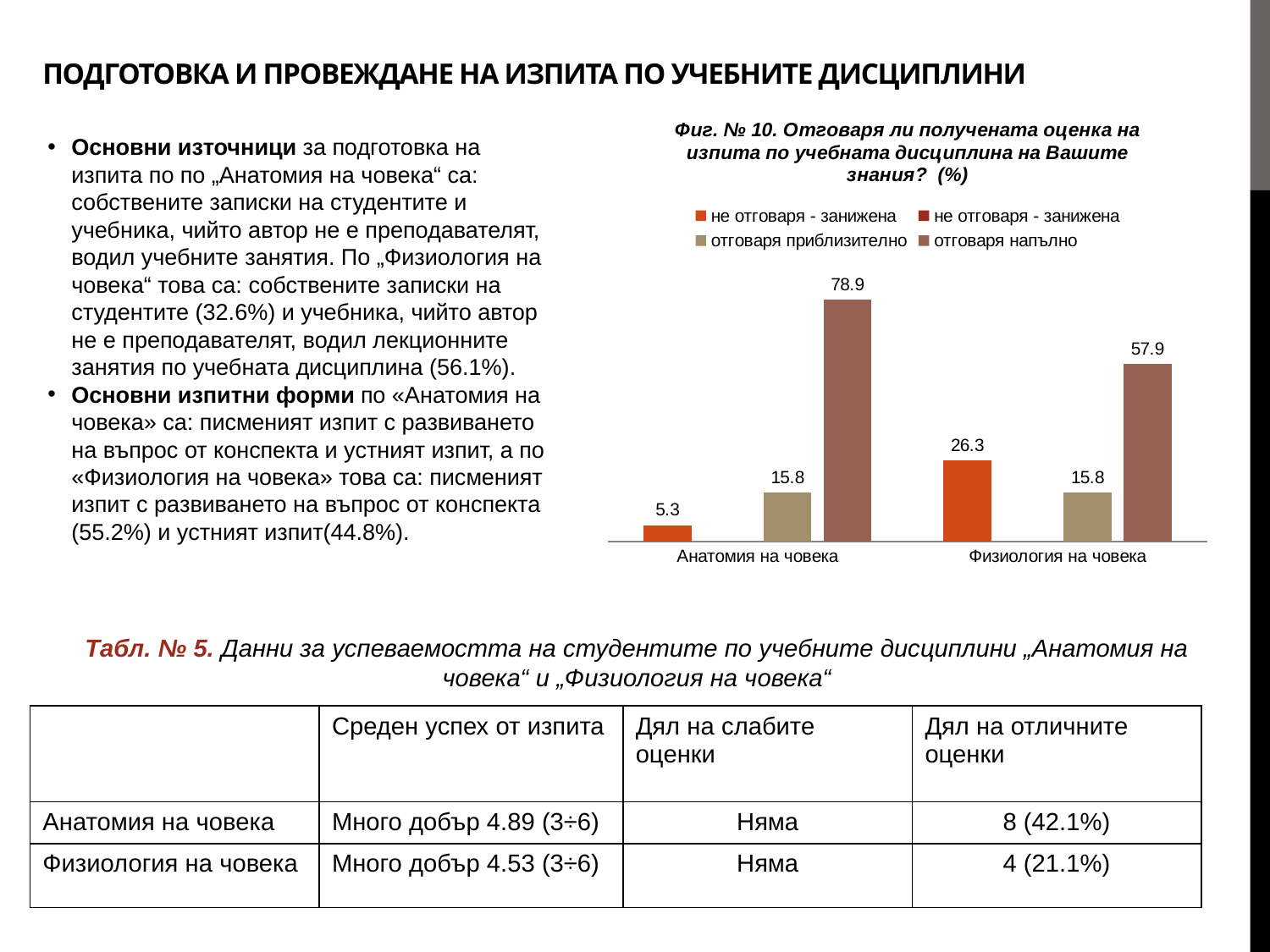
Which discipline has the larger value for the orange "не отговаря - занижена" bar? Физиология на човека What is the value for "отговаря напълно" for Физиология на човека? 57.9 Which bar in the chart has the lowest value? не отговаря - занижена for Анатомия на човека (5.3) What is the difference between the "отговаря напълно" values for Анатомия на човека and Физиология на човека? 21.0 How many entries does the chart legend list? 4 Which bar in the chart has the highest value? отговаря напълно for Анатомия на човека (78.9) What type of chart is shown on the slide? Bar chart What is the value for "отговаря приблизително" for Анатомия на човека? 15.8 What is the figure number of the chart on the slide? Фиг. № 10 How many categories are shown on the x axis of the chart? 2 What is the value for "отговаря напълно" for Анатомия на човека? 78.9 What is the value of the orange bar ("не отговаря - занижена") for Физиология на човека? 26.3